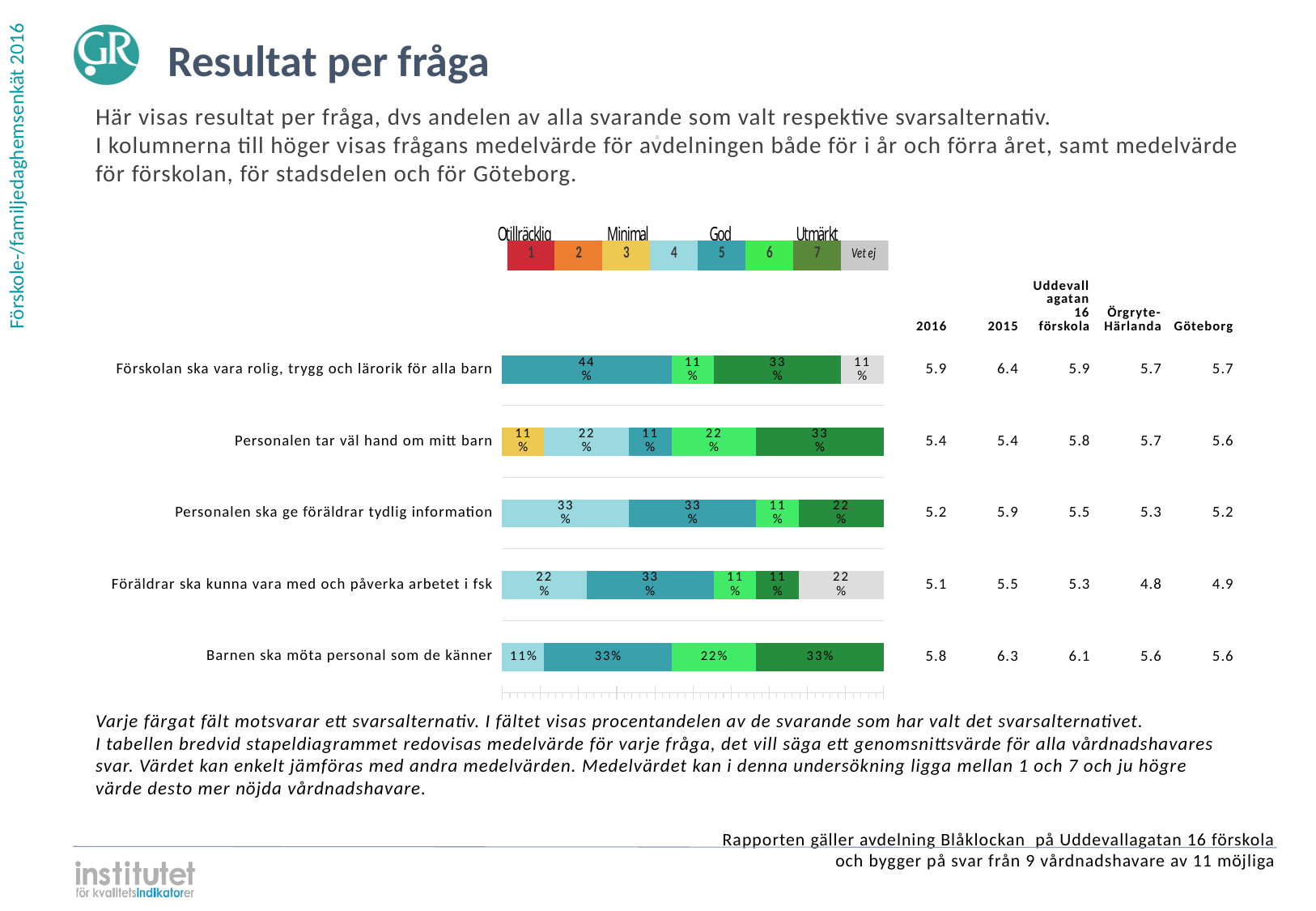
What is the difference between the 2015 and 2016 mean values for 'Barnen ska möta personal som de känner'? 0.5 What kind of chart is used to show the results per question on this slide? Stacked bar chart For 'Personalen ska ge föräldrar tydlig information', which is larger: the 2015 mean or the 2016 mean? 2015 What percentage of respondents answered 'Vet ej' (grey) for 'Föräldrar ska kunna vara med och påverka arbetet i fsk'? 22% Which question has the lowest 2016 mean value? Föräldrar ska kunna vara med och påverka arbetet i fsk What is the Göteborg mean value for 'Föräldrar ska kunna vara med och påverka arbetet i fsk'? 4.9 What label does the legend give to the grey segment in the bars? Vet ej What is the 2016 mean value for 'Personalen tar väl hand om mitt barn'? 5.4 What is the combined percentage of the light green (6) and dark green (7) segments for 'Barnen ska möta personal som de känner'? 55% Which question has the highest 2016 mean value? Förskolan ska vara rolig, trygg och lärorik för alla barn How many questions (categories) are shown as bars in the chart? 5 What percentage of respondents chose the dark green (7, Utmärkt) option for 'Förskolan ska vara rolig, trygg och lärorik för alla barn'? 33%